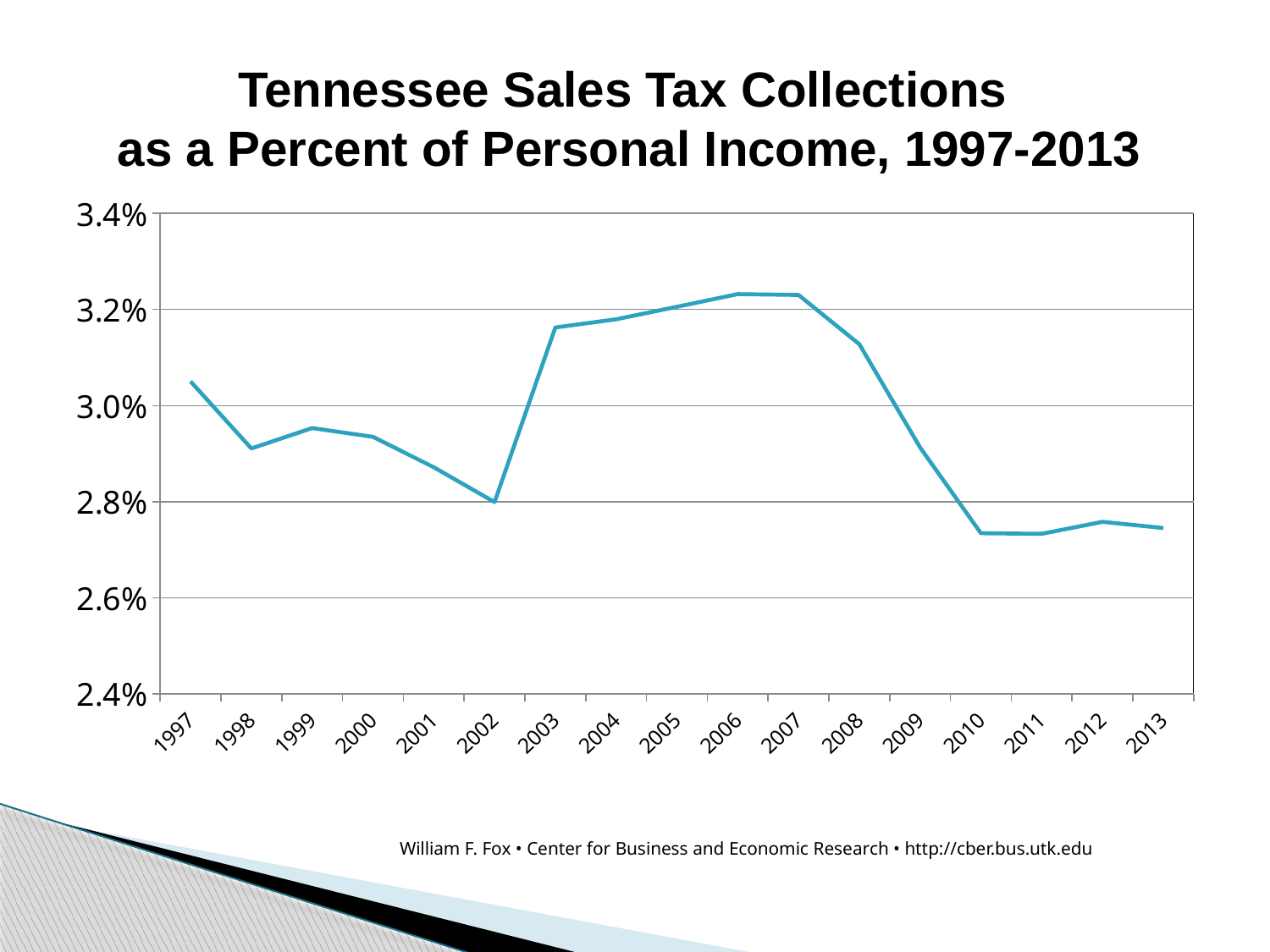
Do the values rise or fall from 2007 to 2010? fall Is the value for 2010 greater or less than 2.8%? less Is the value for 2001 greater or less than 3.0%? less Is the value for 2008 greater or less than 3.0%? greater Which year has the larger value, 2006 or 2010? 2006 Which year has the larger value, 1997 or 2002? 1997 How many years are plotted along the x axis? 17 What is the title of the chart? Tennessee Sales Tax Collections as a Percent of Personal Income, 1997-2013 What kind of chart is shown on the slide? line chart Do the values rise or fall from 2002 to 2006? rise